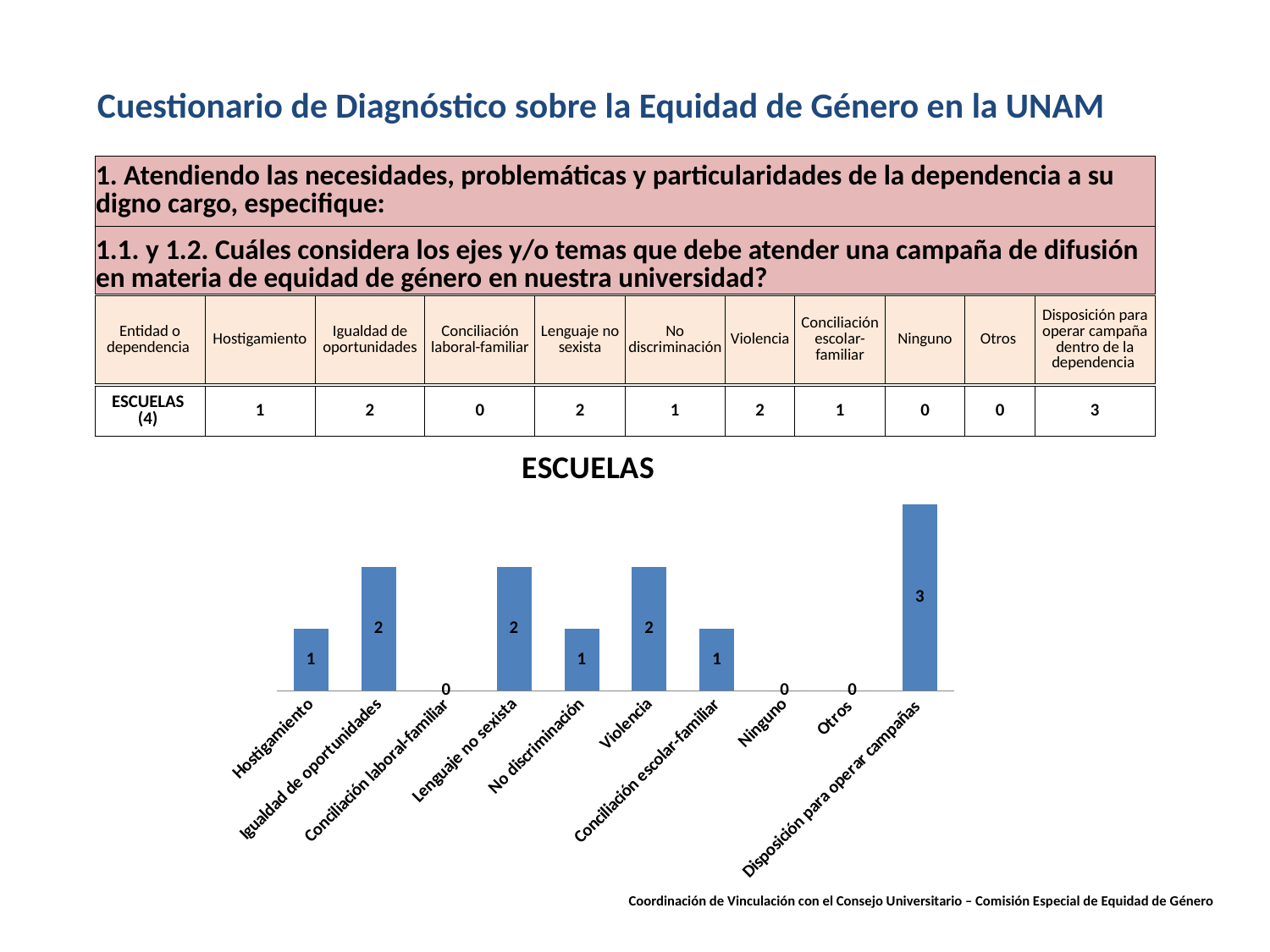
What is the value for Hostigamiento in the ESCUELAS chart? 1 What is the value for Conciliación laboral-familiar in the ESCUELAS chart? 0 What is the difference between the values for Disposición para operar campañas and Igualdad de oportunidades in the ESCUELAS chart? 1 What is the value for Violencia in the ESCUELAS chart? 2 How many categories in the ESCUELAS chart have a value of 0? 3 What kind of chart is the ESCUELAS chart? Bar chart What is the value for Disposición para operar campañas in the ESCUELAS chart? 3 Which is larger in the ESCUELAS chart, the value for Lenguaje no sexista or the value for No discriminación? Lenguaje no sexista What is the title of the chart on the slide? ESCUELAS How many categories are shown in the ESCUELAS chart? 10 What is the value for Conciliación escolar-familiar in the ESCUELAS chart? 1 Which category has the highest value in the ESCUELAS chart? Disposición para operar campañas